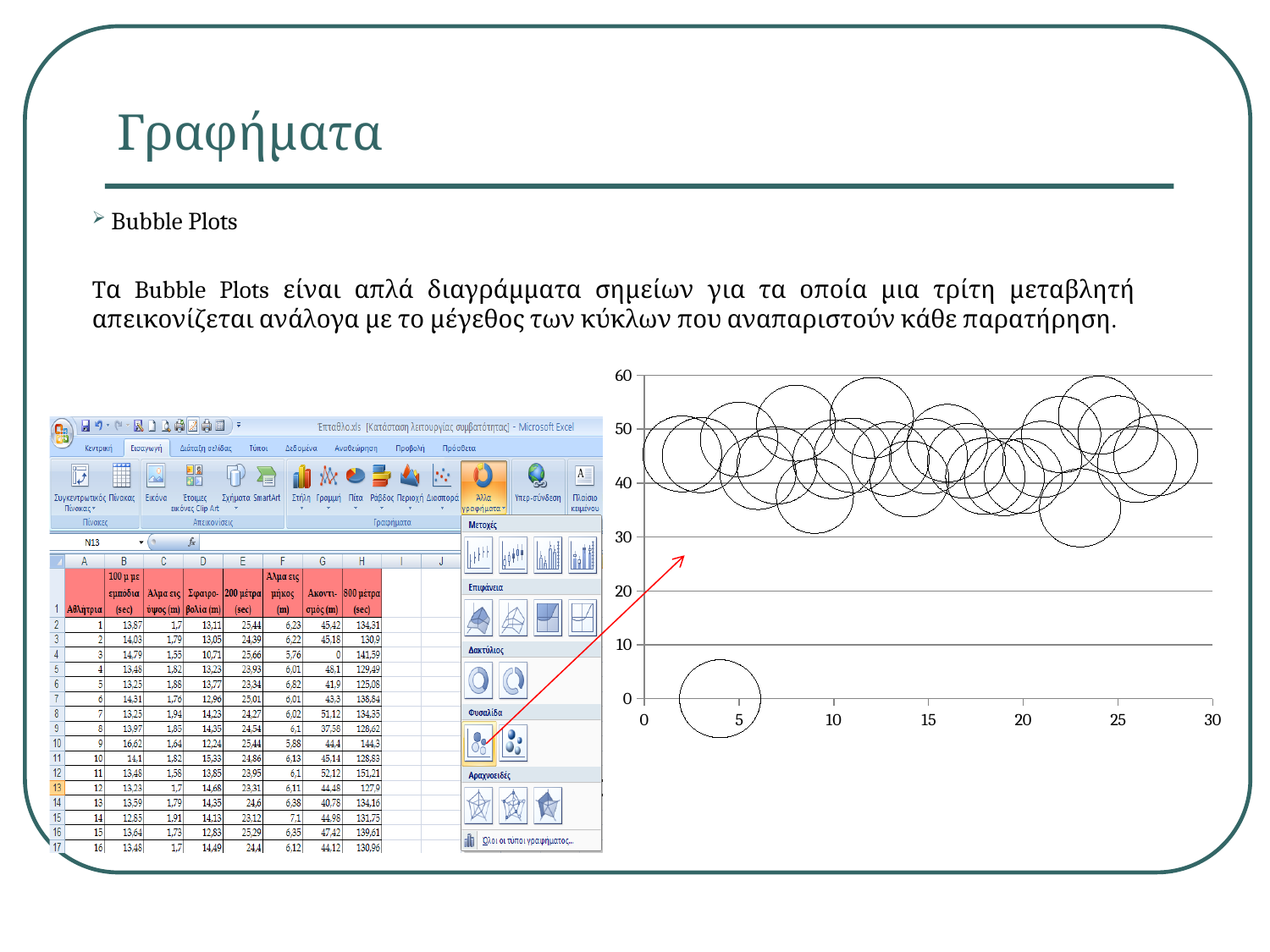
In the bubble chart, are the centres of the large cluster of bubbles greater or less than 30 on the y axis? greater In the bubble chart, is the centre of the isolated bubble at the bottom left greater or less than 10 on the y axis? less What kind of chart is shown on the right side of the slide? bubble chart In the bubble chart, is the centre of the isolated bubble at the bottom left greater or less than 10 on the x axis? less What is the highest value shown on the x axis of the bubble chart? 30 What is the highest value shown on the y axis of the bubble chart? 60